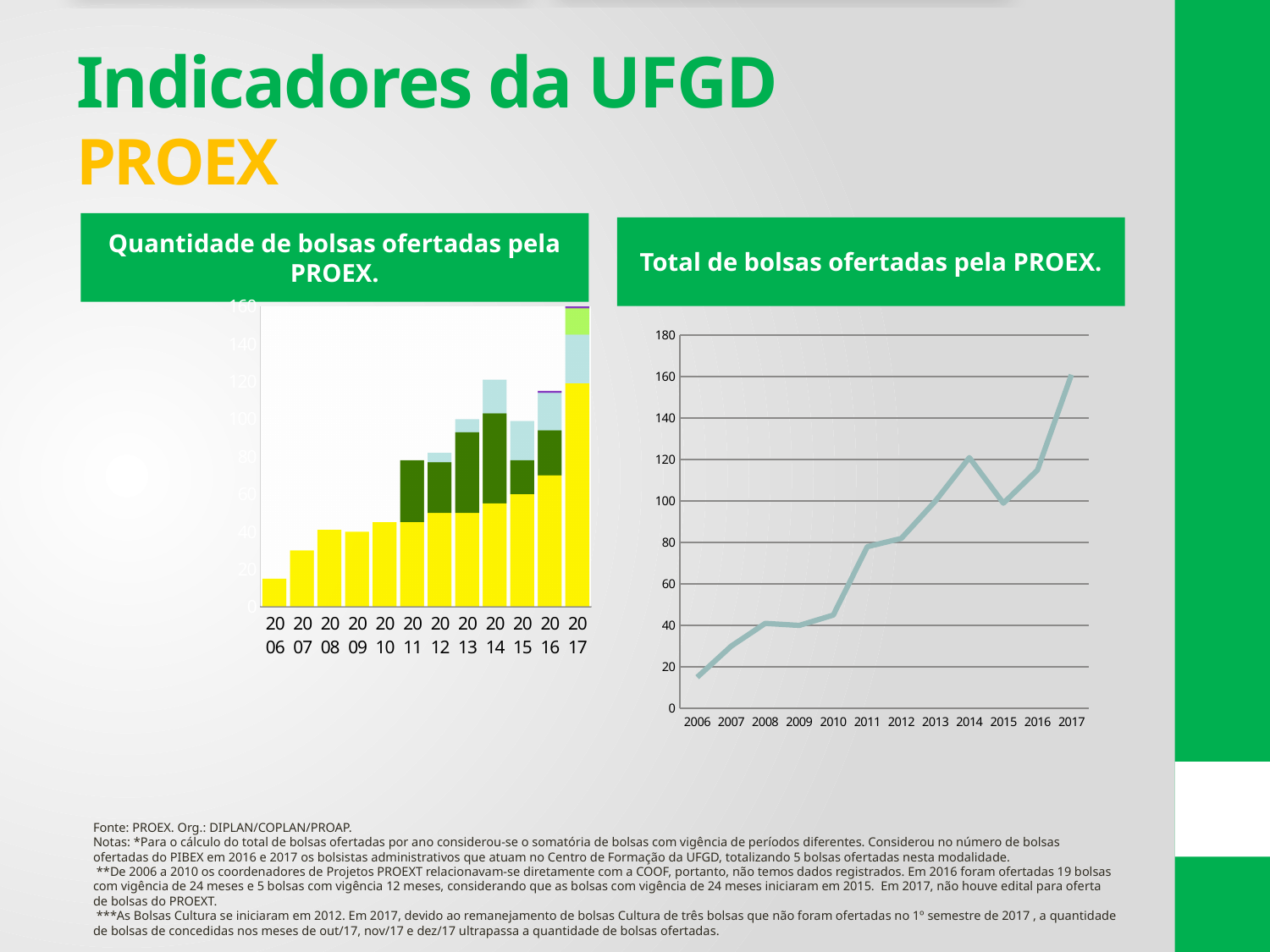
What kind of chart is the chart titled "Total de bolsas ofertadas pela PROEX."? line chart In the chart "Quantidade de bolsas ofertadas pela PROEX.", which year has the tallest stacked bar? 2017 In the chart "Total de bolsas ofertadas pela PROEX.", how many years are plotted on the x axis? 12 In the chart "Total de bolsas ofertadas pela PROEX.", which year has the highest value? 2017 In the chart "Total de bolsas ofertadas pela PROEX.", is the value for 2015 greater or less than 120? less In the chart "Total de bolsas ofertadas pela PROEX.", is the value for 2017 greater or less than 140? greater In the chart "Total de bolsas ofertadas pela PROEX.", do the values generally rise or fall from 2006 to 2017? rise What kind of chart is the chart titled "Quantidade de bolsas ofertadas pela PROEX."? bar chart In the chart "Total de bolsas ofertadas pela PROEX.", which year has the lowest value? 2006 In the chart "Total de bolsas ofertadas pela PROEX.", which year has the larger value, 2014 or 2015? 2014 In the chart "Total de bolsas ofertadas pela PROEX.", is the value for 2006 greater or less than 20? less